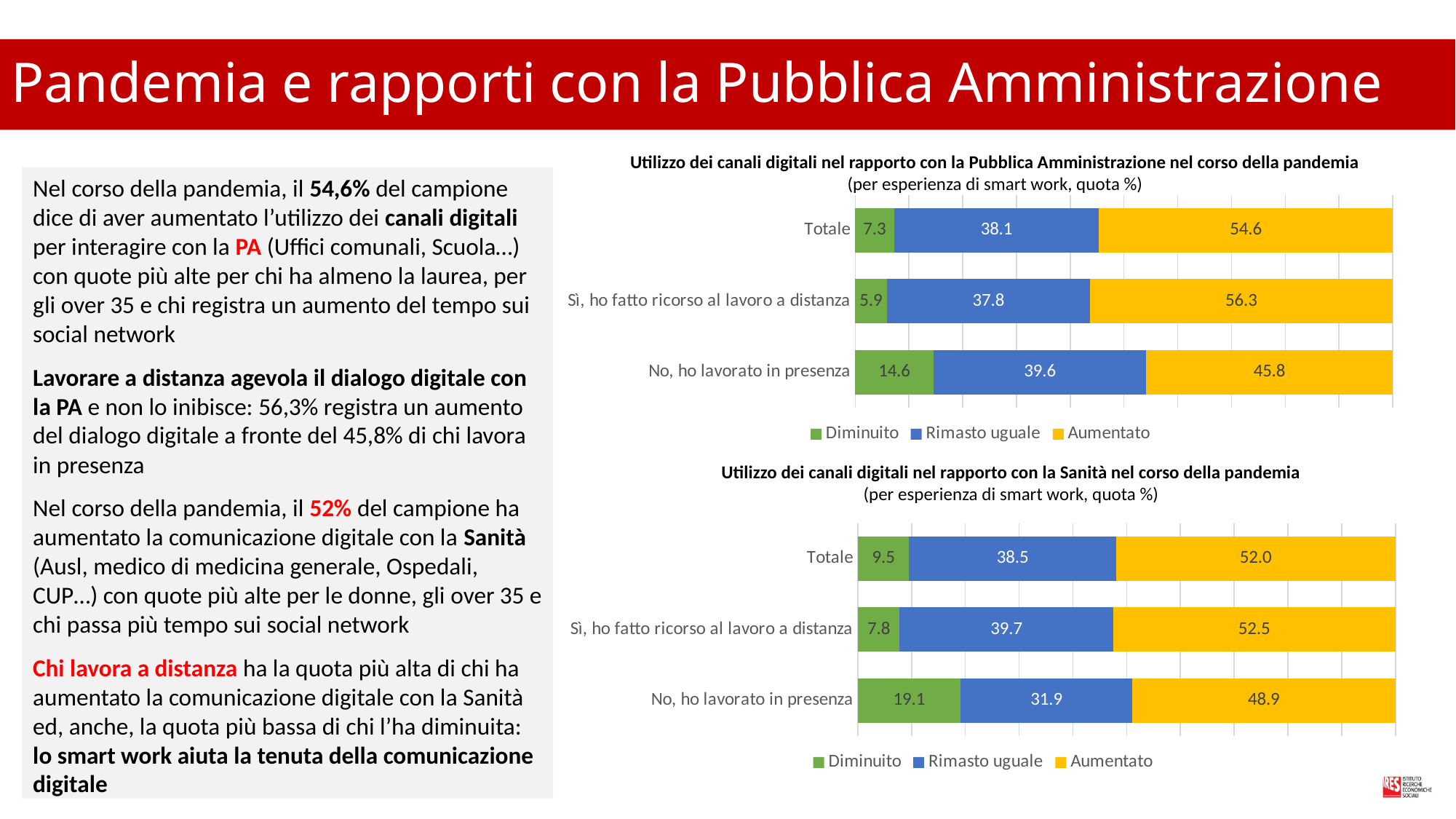
In the bottom chart (Sanità), what is the 'Rimasto uguale' value for 'Sì, ho fatto ricorso al lavoro a distanza'? 39.7 In the top chart (Pubblica Amministrazione), which category has the lowest 'Aumentato' value? No, ho lavorato in presenza In the bottom chart (Sanità), which category has the highest 'Diminuito' value? No, ho lavorato in presenza In the top chart (Pubblica Amministrazione), what is the 'Aumentato' value for 'Totale'? 54.6 How many categories are shown in the top chart (Pubblica Amministrazione)? 3 In the top chart (Pubblica Amministrazione), what is the difference between the 'Aumentato' values for 'Sì, ho fatto ricorso al lavoro a distanza' and 'No, ho lavorato in presenza'? 10.5 In the bottom chart (Sanità), what is the difference between the 'Diminuito' values for 'No, ho lavorato in presenza' and 'Sì, ho fatto ricorso al lavoro a distanza'? 11.3 In the top chart (Pubblica Amministrazione), what is the 'Diminuito' value for 'No, ho lavorato in presenza'? 14.6 How many series does the legend of the bottom chart (Sanità) list? 3 In the top chart (Pubblica Amministrazione), which colour represents 'Aumentato'? Yellow In the bottom chart (Sanità), which is larger: the 'Aumentato' value for 'Totale' or for 'No, ho lavorato in presenza'? Totale What kind of chart is the bottom chart (Sanità)? Stacked bar chart